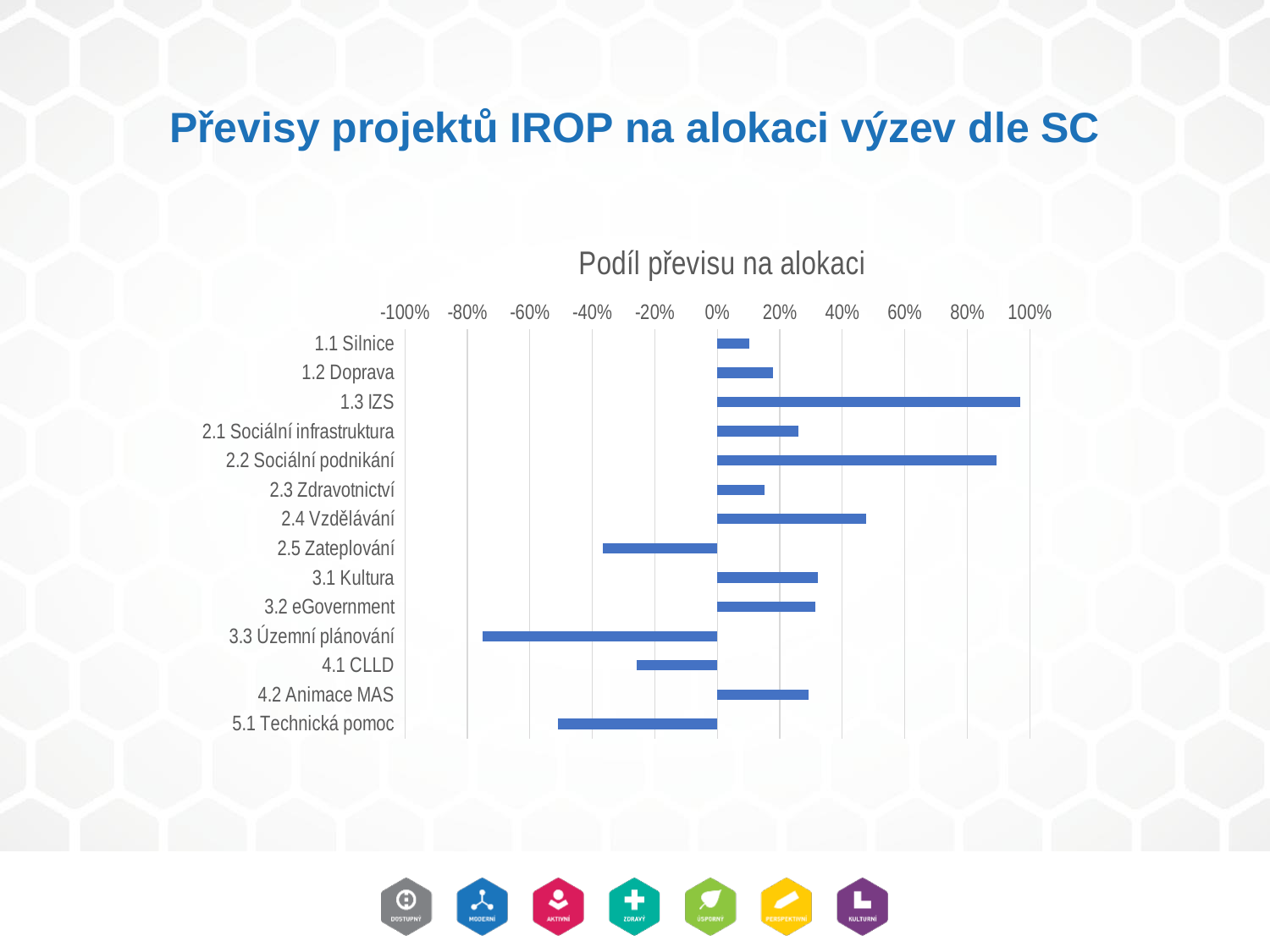
What is the title of the chart? Podíl převisu na alokaci Is the value for 1.1 Silnice greater or less than 20%? less Which category has the highest value in the chart? 1.3 IZS What kind of chart is shown on the slide? bar chart Which has the larger value, 2.4 Vzdělávání or 2.1 Sociální infrastruktura? 2.4 Vzdělávání Is the value for 3.3 Územní plánování greater or less than -60%? less Is the value for 1.3 IZS greater or less than 80%? greater Which category has the lowest value in the chart? 3.3 Územní plánování How many categories have a negative value in the chart? 4 Which has the larger value, 4.2 Animace MAS or 4.1 CLLD? 4.2 Animace MAS How many categories are plotted in the chart? 14